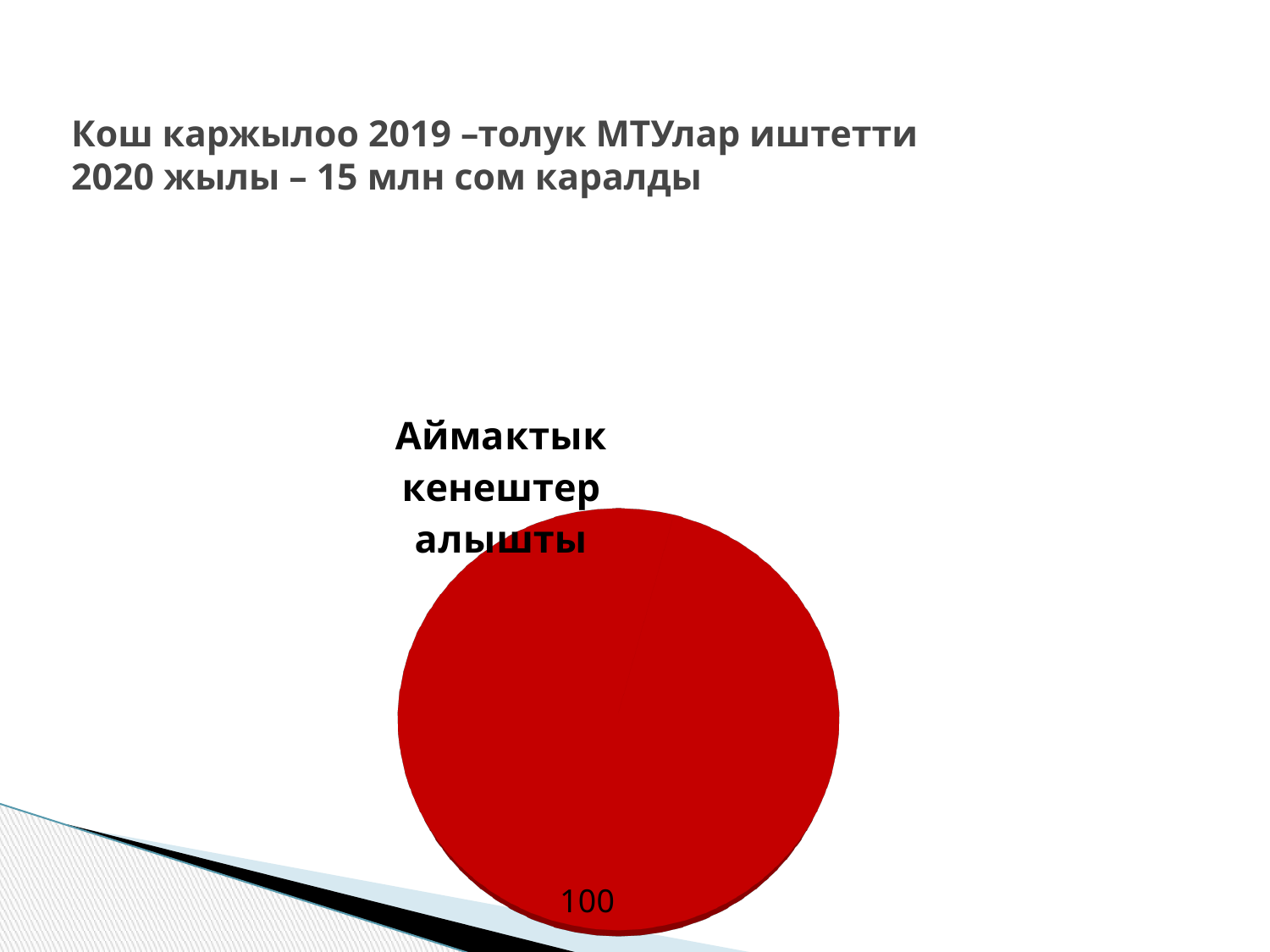
What is the title of the chart? Аймактык кенештер алышты What kind of chart is shown on the slide? pie chart What colour is the slice of the pie chart? red How many slices does the pie chart have? 1 Is the value printed on the pie chart slice greater or less than 50? greater What value is printed on the slice of the pie chart? 100